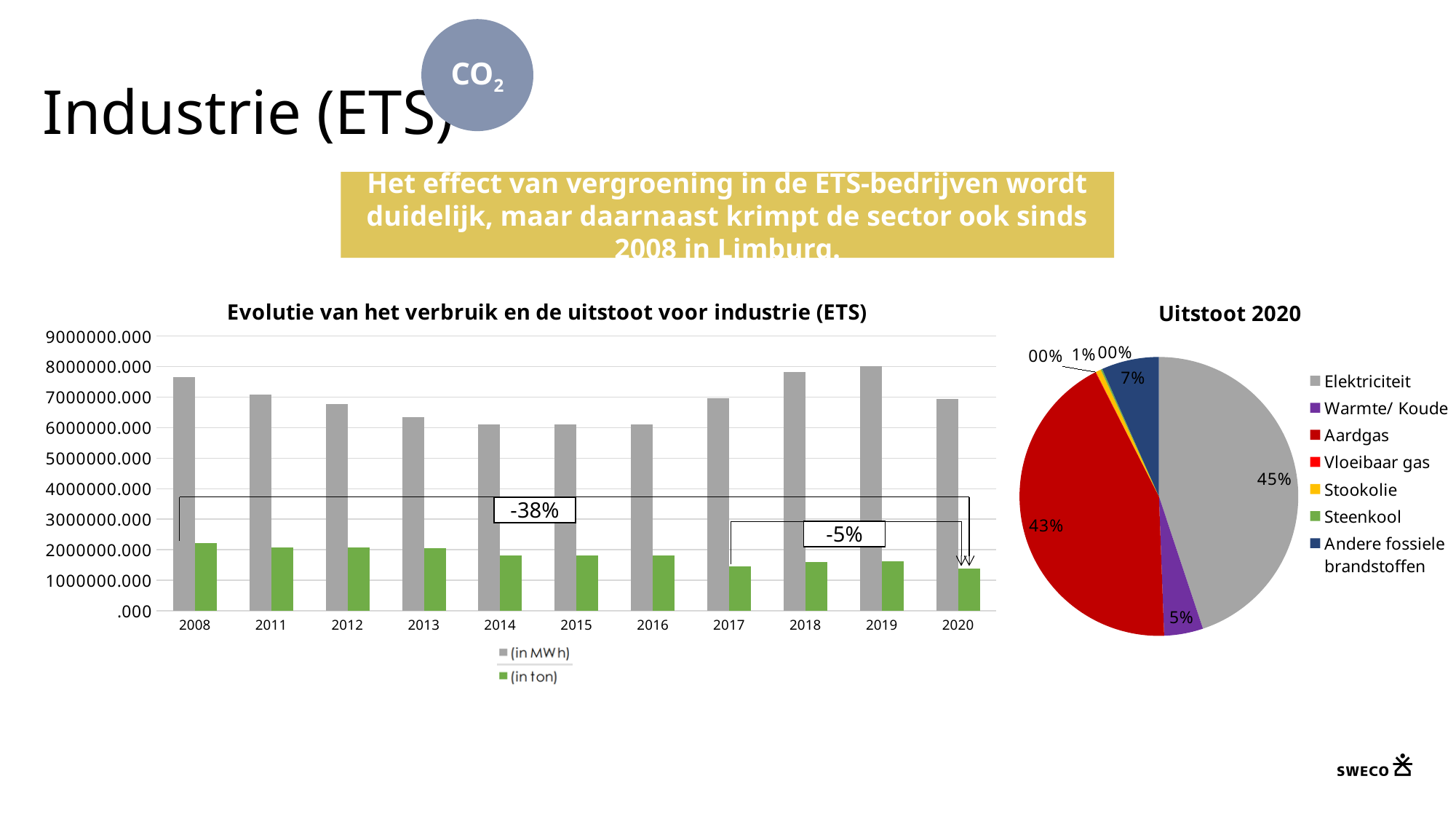
In the chart 'Evolutie van het verbruik en de uitstoot voor industrie (ETS)', which year has the highest '(in MWh)' bar? 2019 In the chart 'Evolutie van het verbruik en de uitstoot voor industrie (ETS)', what percentage change is annotated between 2008 and 2020? -38% In the chart 'Evolutie van het verbruik en de uitstoot voor industrie (ETS)', how many years are shown on the x axis? 11 In the pie chart 'Uitstoot 2020', what share does Aardgas have? 43% In the chart 'Evolutie van het verbruik en de uitstoot voor industrie (ETS)', is the value of '(in MWh)' for 2019 greater or less than 7000000.000? greater What kind of chart is 'Evolutie van het verbruik en de uitstoot voor industrie (ETS)'? bar chart In the chart 'Evolutie van het verbruik en de uitstoot voor industrie (ETS)', is the value of '(in ton)' for 2020 greater or less than 2000000.000? less In the chart 'Evolutie van het verbruik en de uitstoot voor industrie (ETS)', how many series does the legend list? 2 In the chart 'Evolutie van het verbruik en de uitstoot voor industrie (ETS)', do the '(in ton)' values rise or fall overall from 2008 to 2020? fall What kind of chart is 'Uitstoot 2020'? pie chart In the pie chart 'Uitstoot 2020', how many categories does the legend list? 7 In the pie chart 'Uitstoot 2020', which category has the largest slice? Elektriciteit